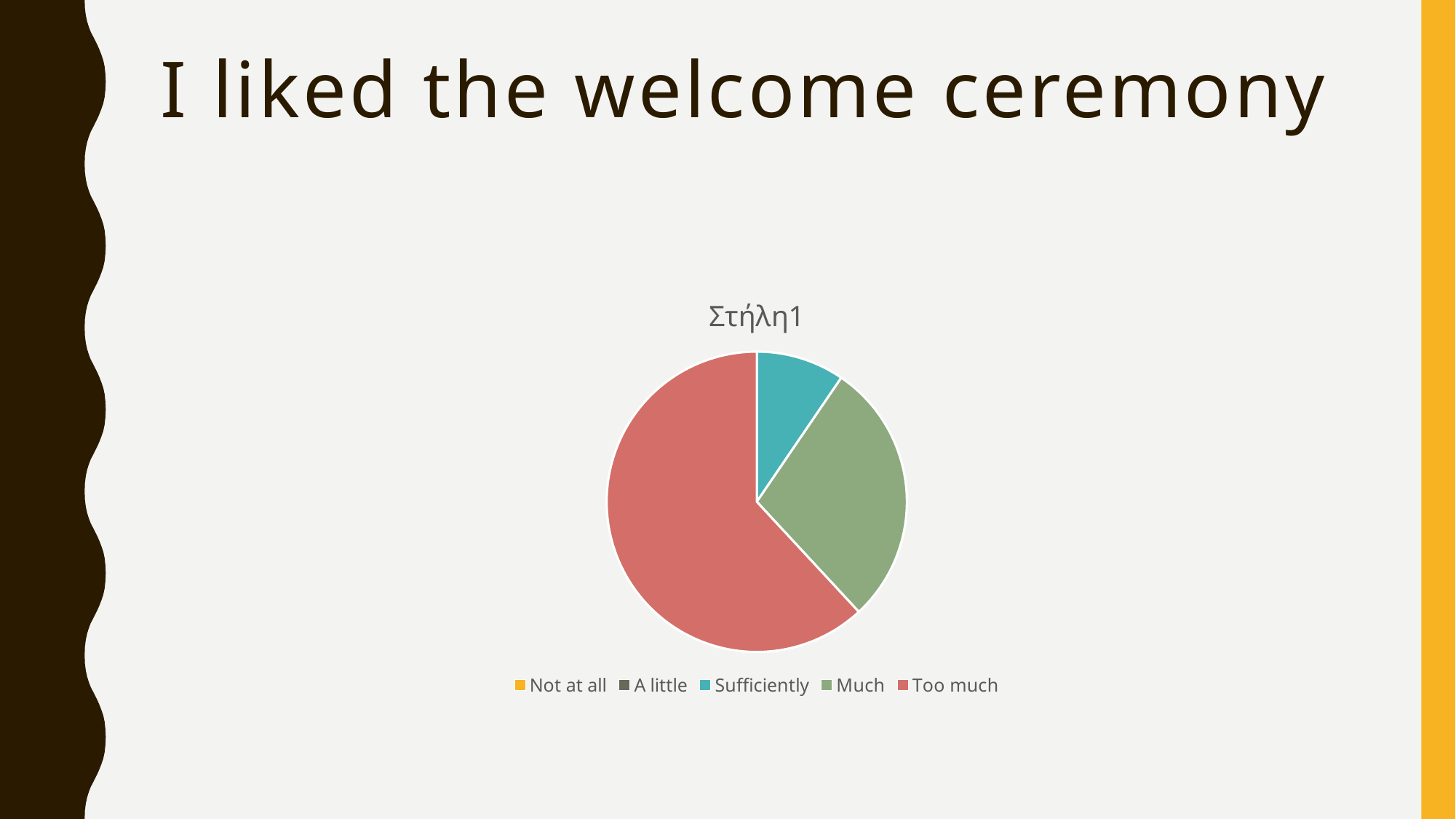
How many entries does the legend of the pie chart list? 5 How many slices are visible in the pie chart? 3 Which slice is larger, Much or Sufficiently? Much Which legend entry is listed first in the pie chart's legend? Not at all What kind of chart is shown on the slide? pie chart Which category has the largest slice of the pie? Too much What colour is the Too much slice in the pie chart? red Which slice is larger, Too much or Much? Too much What is the title shown above the pie chart? Στήλη1 Which slice is smaller, Sufficiently or Too much? Sufficiently